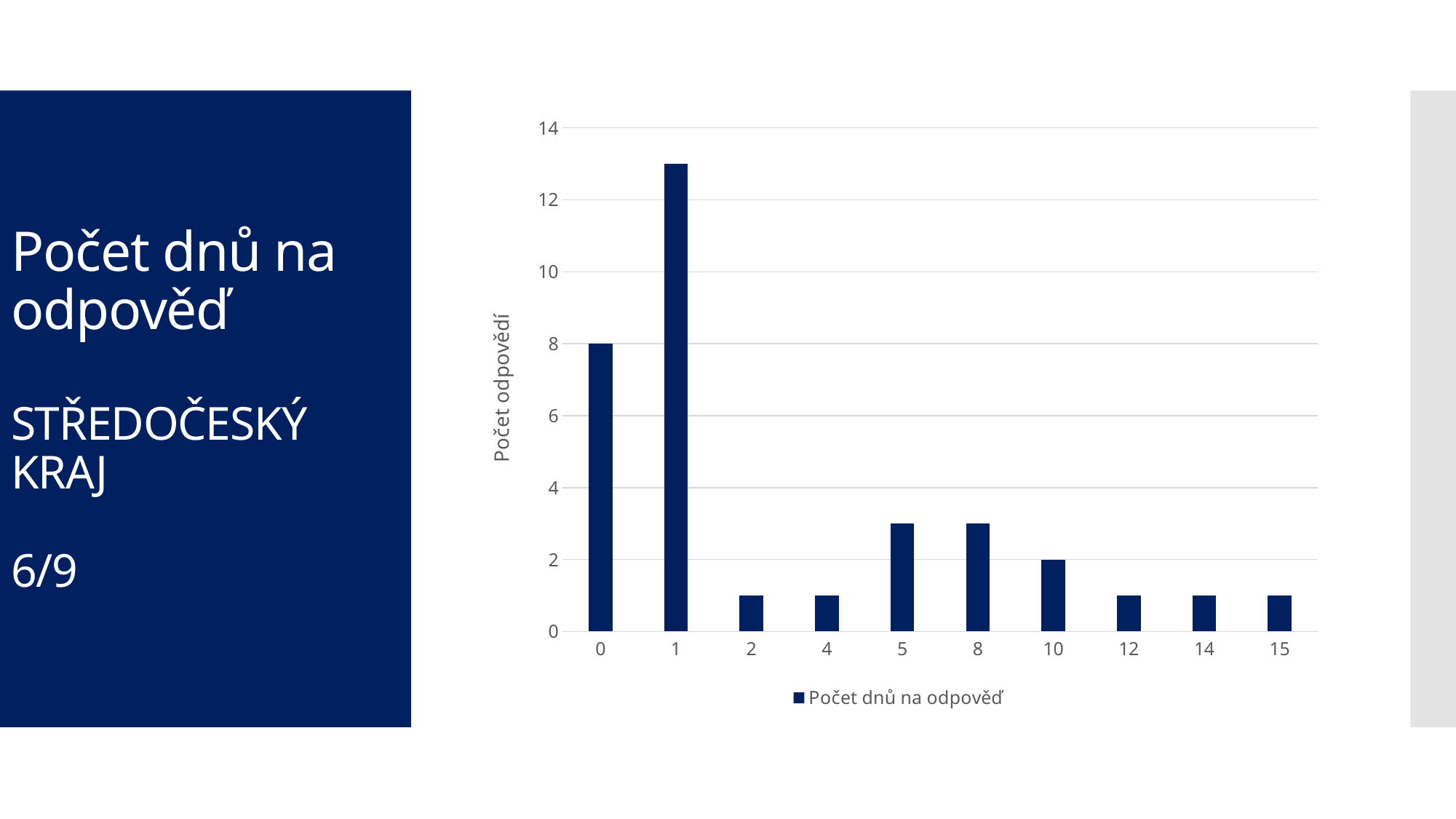
What is the value (Počet odpovědí) for category 0? 8 What kind of chart is shown on the slide? bar chart Is the value for category 1 greater or less than 12? greater Is the value for category 2 greater or less than 2? less How many categories are shown on the x axis of the chart? 10 What is the difference between the values for category 0 and category 10? 6 Is the value for category 5 greater or less than 4? less What is the label of the series in the legend? Počet dnů na odpověď How many series does the legend list? 1 Which category has the highest value? 1 Which has the larger value, category 0 or category 1? 1 What is the value (Počet odpovědí) for category 10? 2